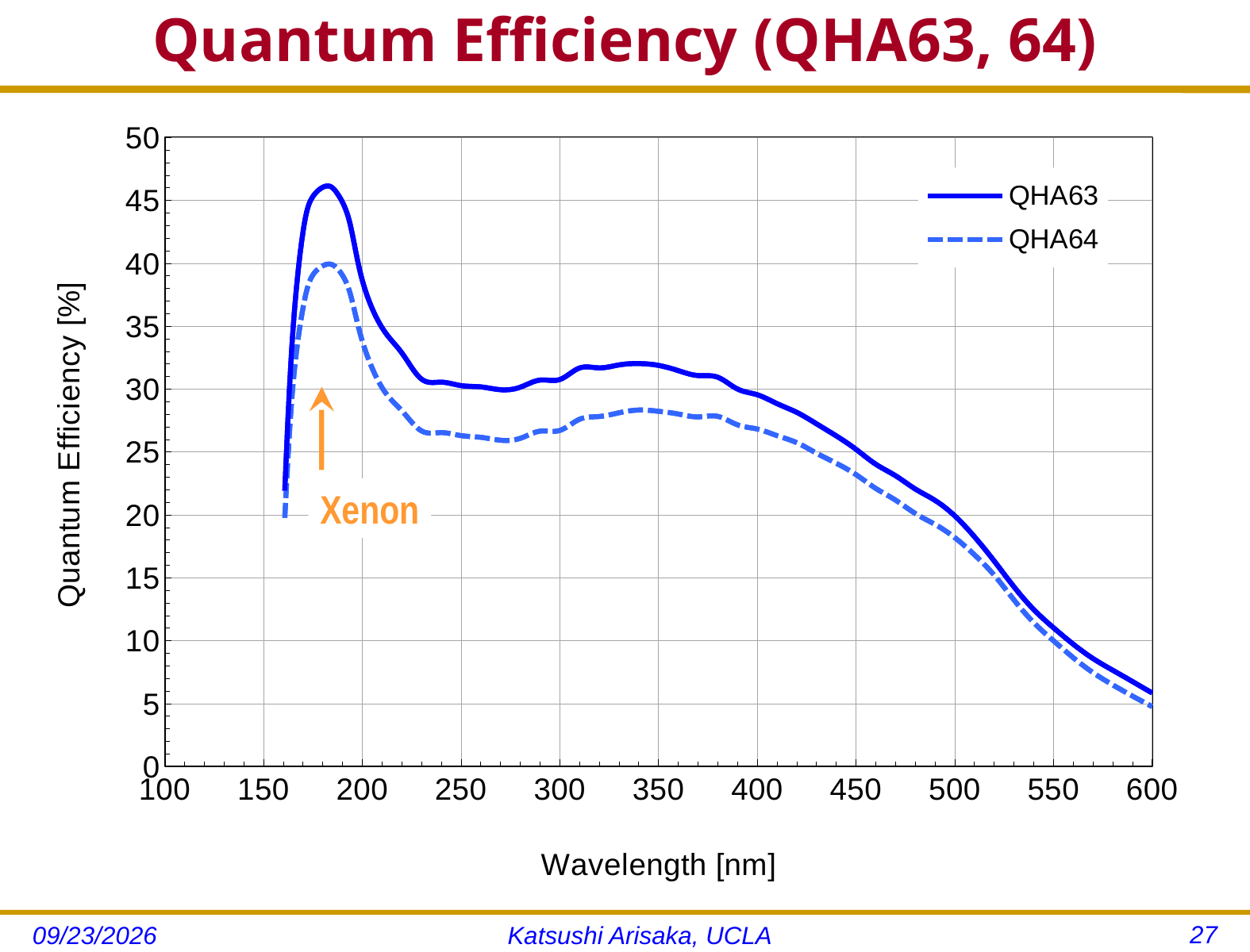
How many series does the legend list? 2 Is the quantum efficiency of QHA64 at 250 nm greater or less than 25? greater Which series reaches the higher peak quantum efficiency, QHA63 or QHA64? QHA63 Is the quantum efficiency of QHA63 at 550 nm greater or less than 10? greater What are the names of the two series in the legend? QHA63 and QHA64 Is the quantum efficiency of QHA64 at 500 nm greater or less than 20? less At 350 nm, which series has the higher quantum efficiency, QHA63 or QHA64? QHA63 What kind of chart is shown on the slide? line chart What label does the orange arrow annotation on the chart carry? Xenon Between 350 nm and 600 nm, do the QHA63 values rise or fall as wavelength increases? fall